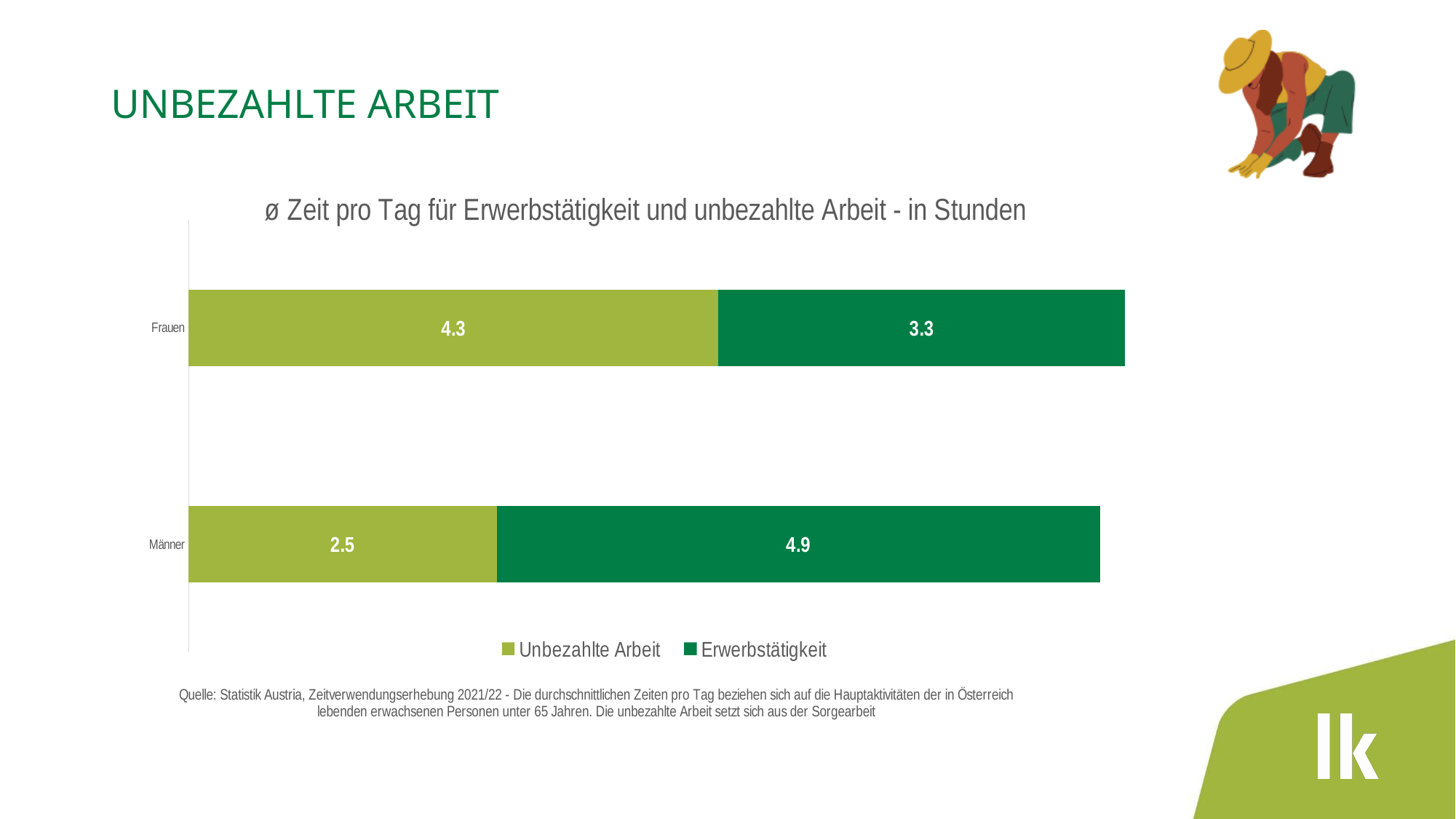
What kind of chart is shown on the slide? Stacked bar chart What is the value for Unbezahlte Arbeit for Männer? 2.5 Which is larger: Erwerbstätigkeit for Männer or Erwerbstätigkeit for Frauen? Männer What is the value for Erwerbstätigkeit for Frauen? 3.3 What is the difference between the Unbezahlte Arbeit values for Frauen and Männer? 1.8 How many series does the legend list? 2 What is the total of the stacked bar for Frauen? 7.6 Which category has the lowest value for Erwerbstätigkeit? Frauen Which category has the highest value for Unbezahlte Arbeit? Frauen What is the value for Erwerbstätigkeit for Männer? 4.9 What is the total of the stacked bar for Männer? 7.4 What is the value for Unbezahlte Arbeit for Frauen? 4.3